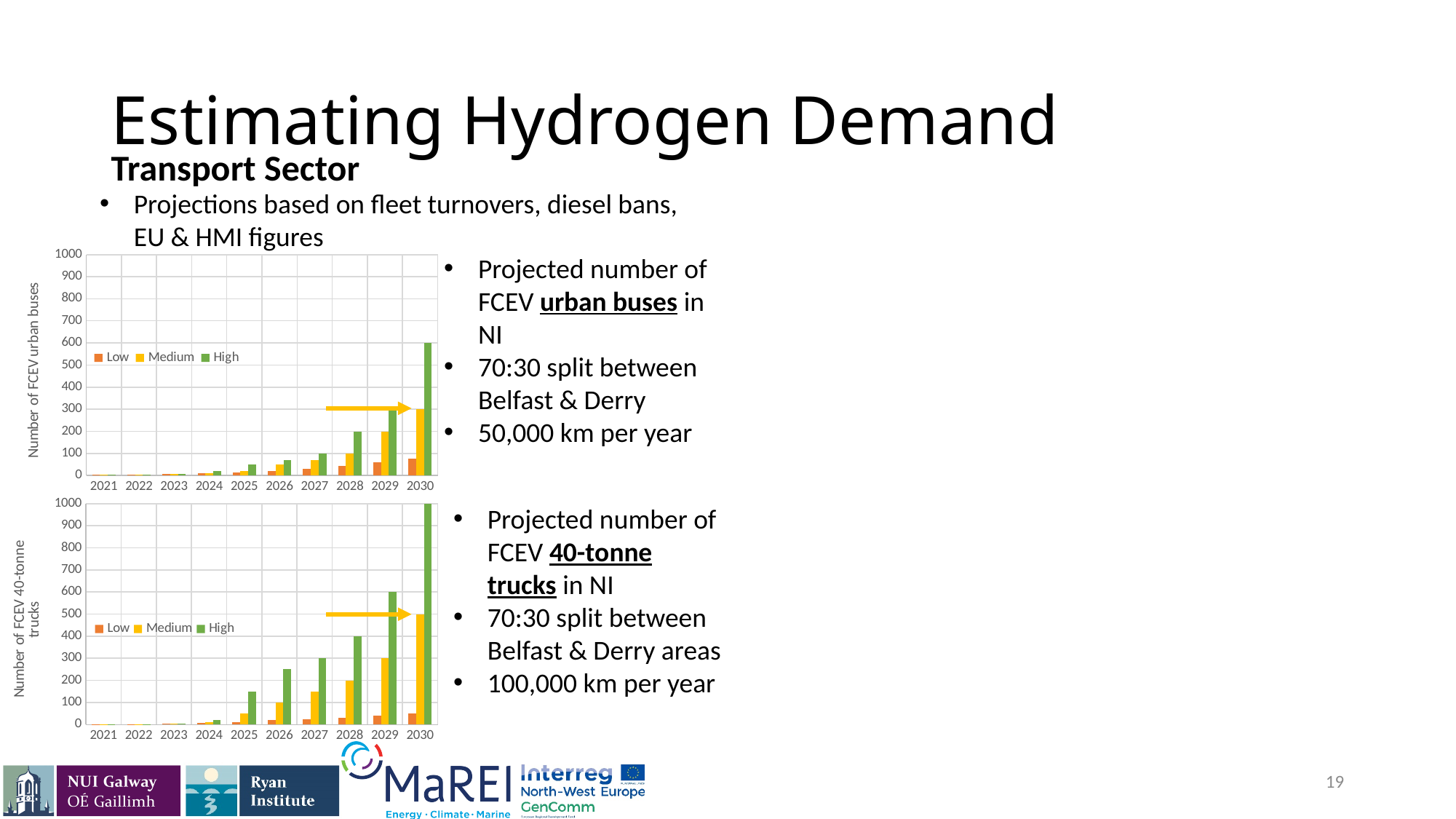
What kind of chart is the top chart (Number of FCEV urban buses)? bar chart How many series does the legend list in the bottom chart (Number of FCEV 40-tonne trucks)? 3 In the bottom chart (Number of FCEV 40-tonne trucks), which is larger in 2028: the Medium value or the High value? High In the top chart (Number of FCEV urban buses), is the Low value for 2030 greater or less than 100? less In the bottom chart (Number of FCEV 40-tonne trucks), which series has the lowest value in 2030? Low How many years are shown on the x axis of the bottom chart (Number of FCEV 40-tonne trucks)? 10 In the bottom chart (Number of FCEV 40-tonne trucks), is the High value for 2030 greater or less than 900? greater What are the legend entries in the top chart (Number of FCEV urban buses)? Low, Medium, High In the bottom chart (Number of FCEV 40-tonne trucks), is the Medium value for 2029 greater or less than 200? greater In the top chart (Number of FCEV urban buses), which year has the highest High value? 2030 In the top chart (Number of FCEV urban buses), do the High values rise or fall from 2021 to 2030? rise